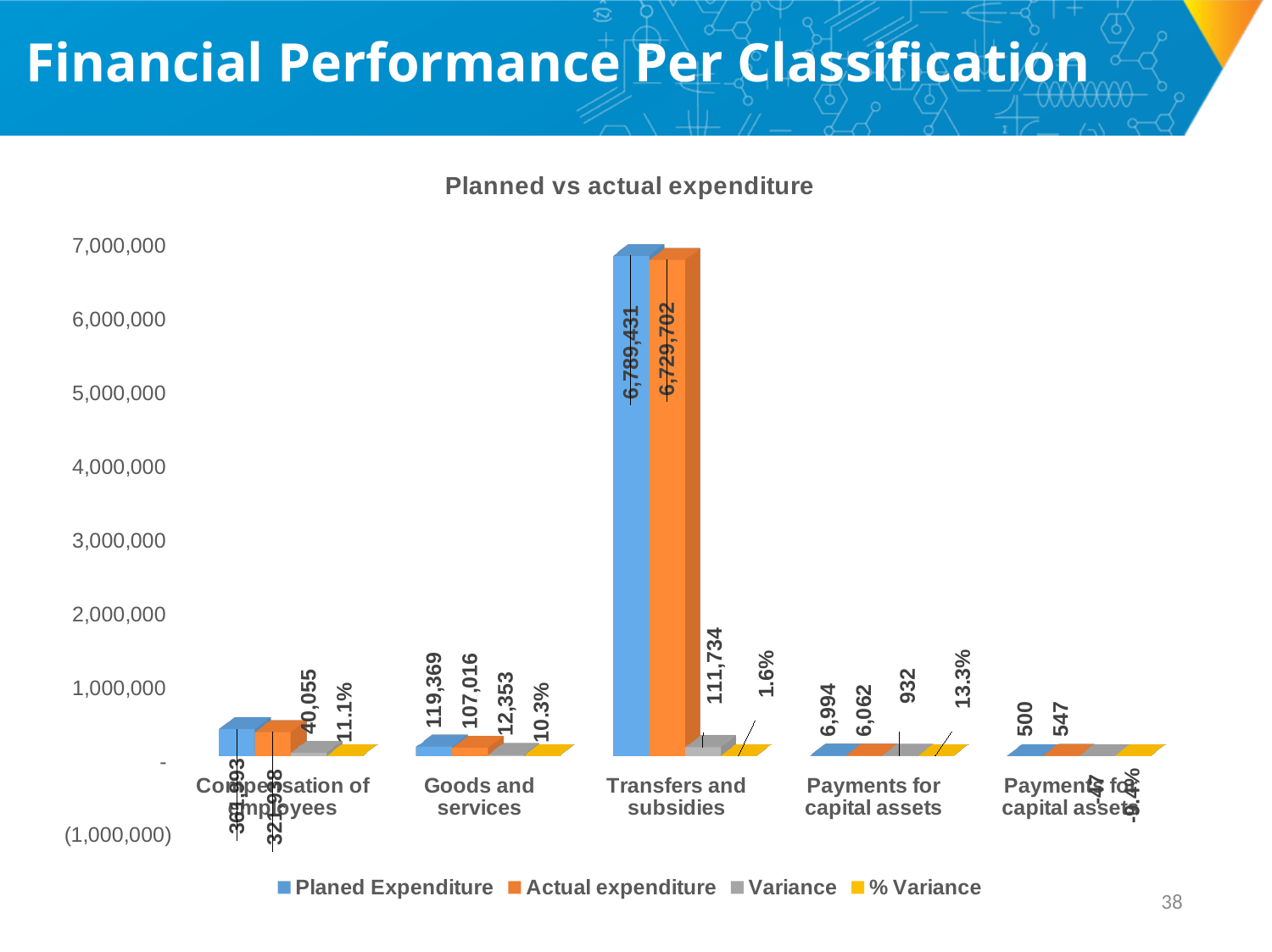
Which category has the highest Planed Expenditure? Transfers and subsidies What is the difference between Planed Expenditure and Actual expenditure for Goods and services? 12,353 How many series does the legend list? 4 What is the % Variance for Goods and services? 10.3% What is the title of the chart? Planned vs actual expenditure How many categories are shown on the x axis? 5 What is the Actual expenditure value for Transfers and subsidies? 6,729,702 Is the Planed Expenditure for Transfers and subsidies greater or less than 6,000,000? greater For Goods and services, which is larger: Planed Expenditure or Actual expenditure? Planed Expenditure What is the Planed Expenditure value for Goods and services? 119,369 What kind of chart is shown on the slide? bar chart What is the Variance value for Transfers and subsidies? 111,734